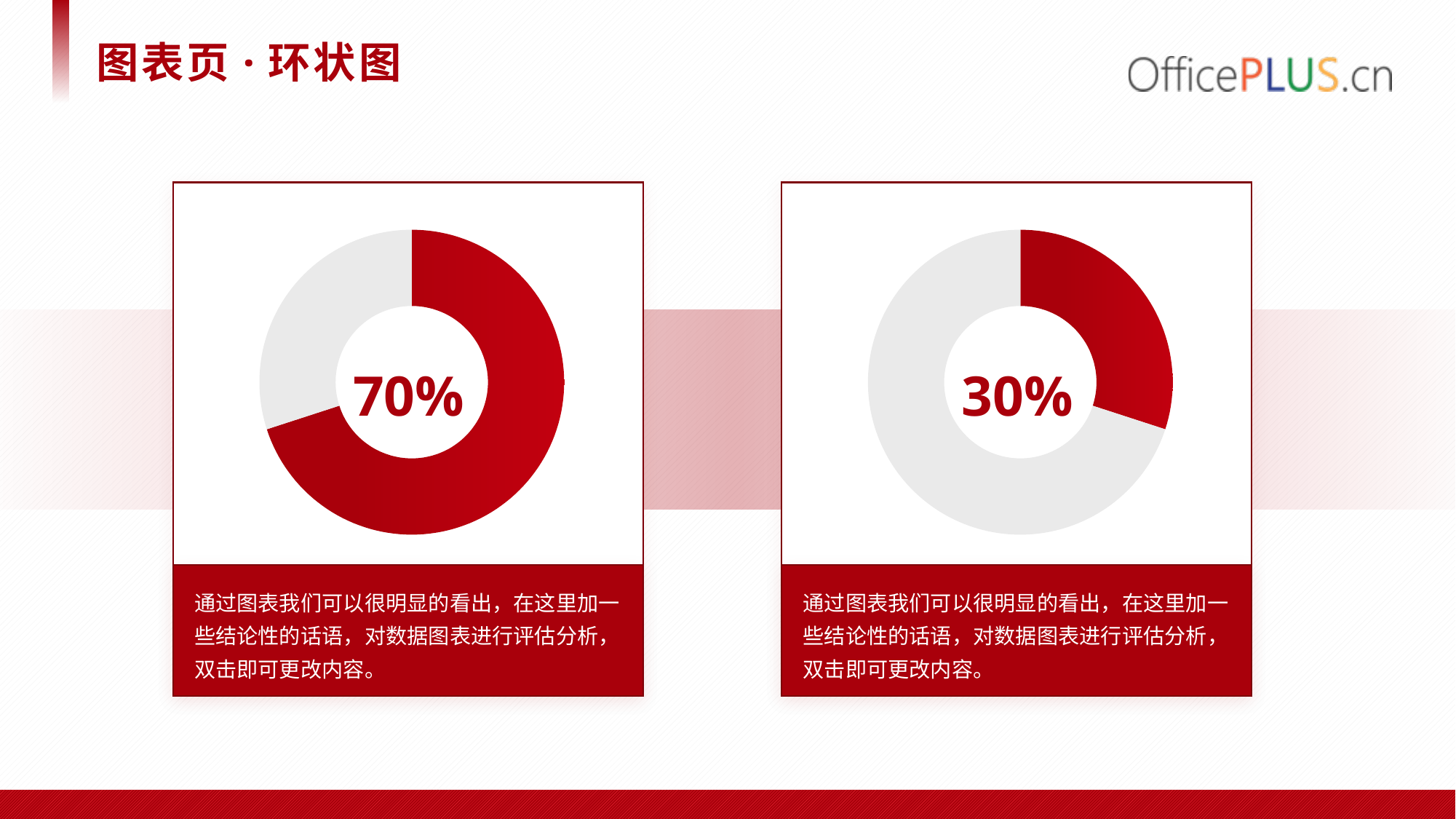
What kind of chart is shown on the right of the slide? Donut chart What percentage is displayed in the centre of the left donut chart? 70% What kind of chart is shown on the left of the slide? Donut chart Which chart shows the larger percentage, the left one or the right one? The left one How many donut charts are on the slide? 2 In the right donut chart, is the red portion greater or less than 50%? less What is the title of the slide? 图表页·环状图 What is the difference between the percentage in the left chart and the percentage in the right chart? 40 percentage points In the left donut chart, is the red portion greater or less than 50%? greater In the left donut chart, what share of the ring is filled in red? 70% In the right donut chart, what share of the ring is filled in red? 30% What percentage is displayed in the centre of the right donut chart? 30%